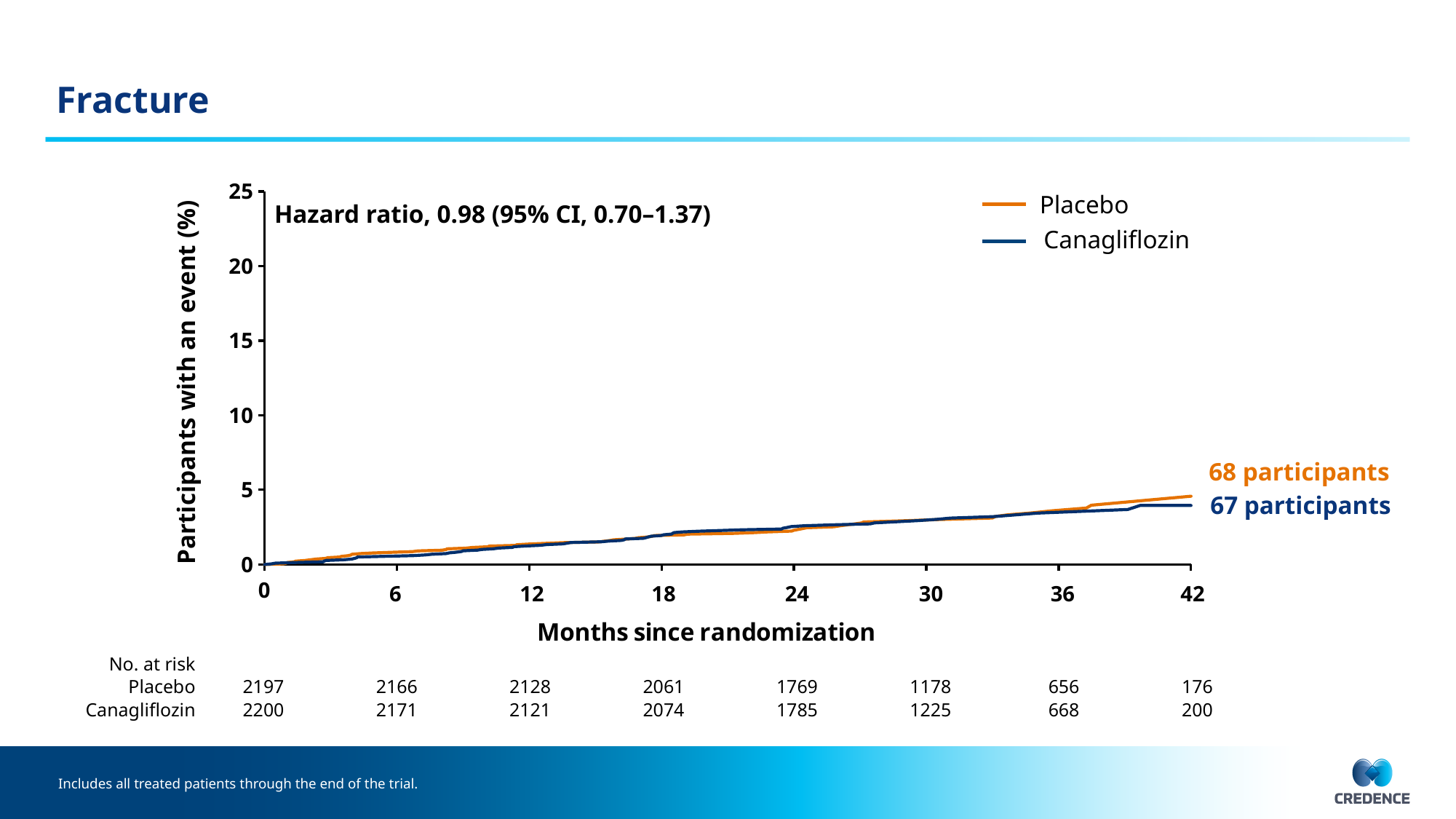
Do the curves rise or fall as months since randomization increase? rise How many participants in the Canagliflozin group had a fracture event? 67 participants What hazard ratio is reported on the chart? 0.98 Is the percentage of Placebo participants with an event at 42 months greater or less than 10? less How many Canagliflozin participants were at risk at month 42? 200 How many series does the legend list? 2 What kind of chart is shown on the slide? line chart What is the 95% confidence interval for the hazard ratio? 0.70–1.37 What is the difference between the number of Placebo participants with an event and the number of Canagliflozin participants with an event? 1 Which group had more participants with an event, Placebo or Canagliflozin? Placebo What is the title of the x axis? Months since randomization How many participants in the Placebo group had a fracture event? 68 participants